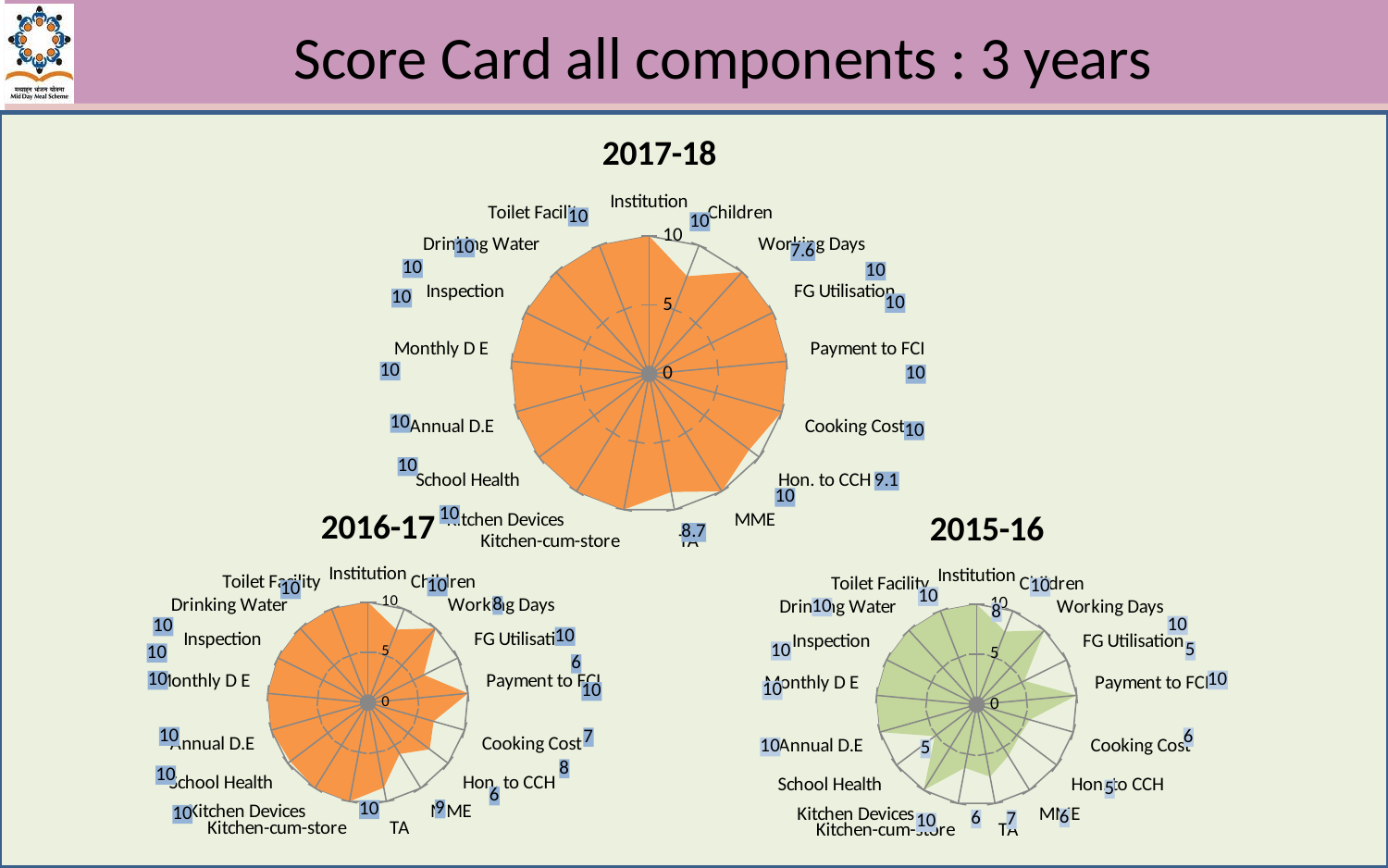
In the 2017-18 chart, which component has the lowest score? Children In the 2017-18 chart, what is the score for TA? 8.7 In the 2017-18 chart, what is the score for Working Days? 10 In the 2015-16 chart, what is the score for Cooking Cost? 6 How many radar charts are shown on the slide? 3 In the 2017-18 chart, what is the difference between the Hon. to CCH score and the Working Days score? 0.9 In the 2015-16 chart, what is the score for FG Utilisation? 5 In the 2017-18 chart, which is larger: the score for Hon. to CCH or the score for TA? Hon. to CCH In the 2016-17 chart, what is the score for Hon. to CCH? 8 In the 2017-18 chart, what is the score for Hon. to CCH? 9.1 In the 2016-17 chart, what is the score for Cooking Cost? 7 What kind of chart is used for the 2017-18 score card? Radar chart